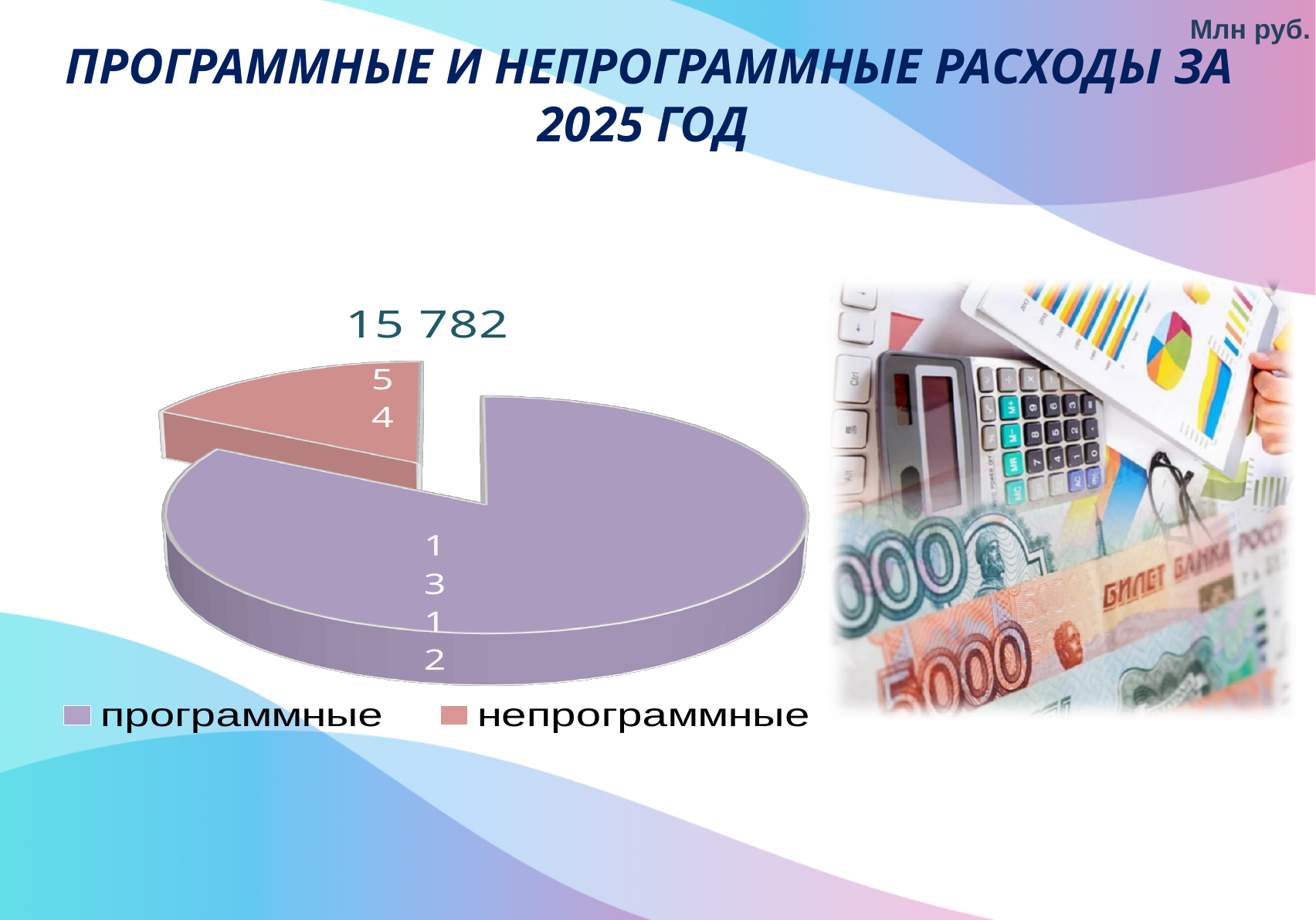
Which category has the largest share of the pie chart? программные Which slice of the pie chart is larger, программные or непрограммные? программные What total value is printed above the pie chart? 15 782 What kind of chart is shown on the slide? pie chart How many slices does the pie chart have? 2 Which category has the smallest share of the pie chart? непрограммные What colour is the непрограммные slice in the pie chart? pink How many entries does the legend of the pie chart list? 2